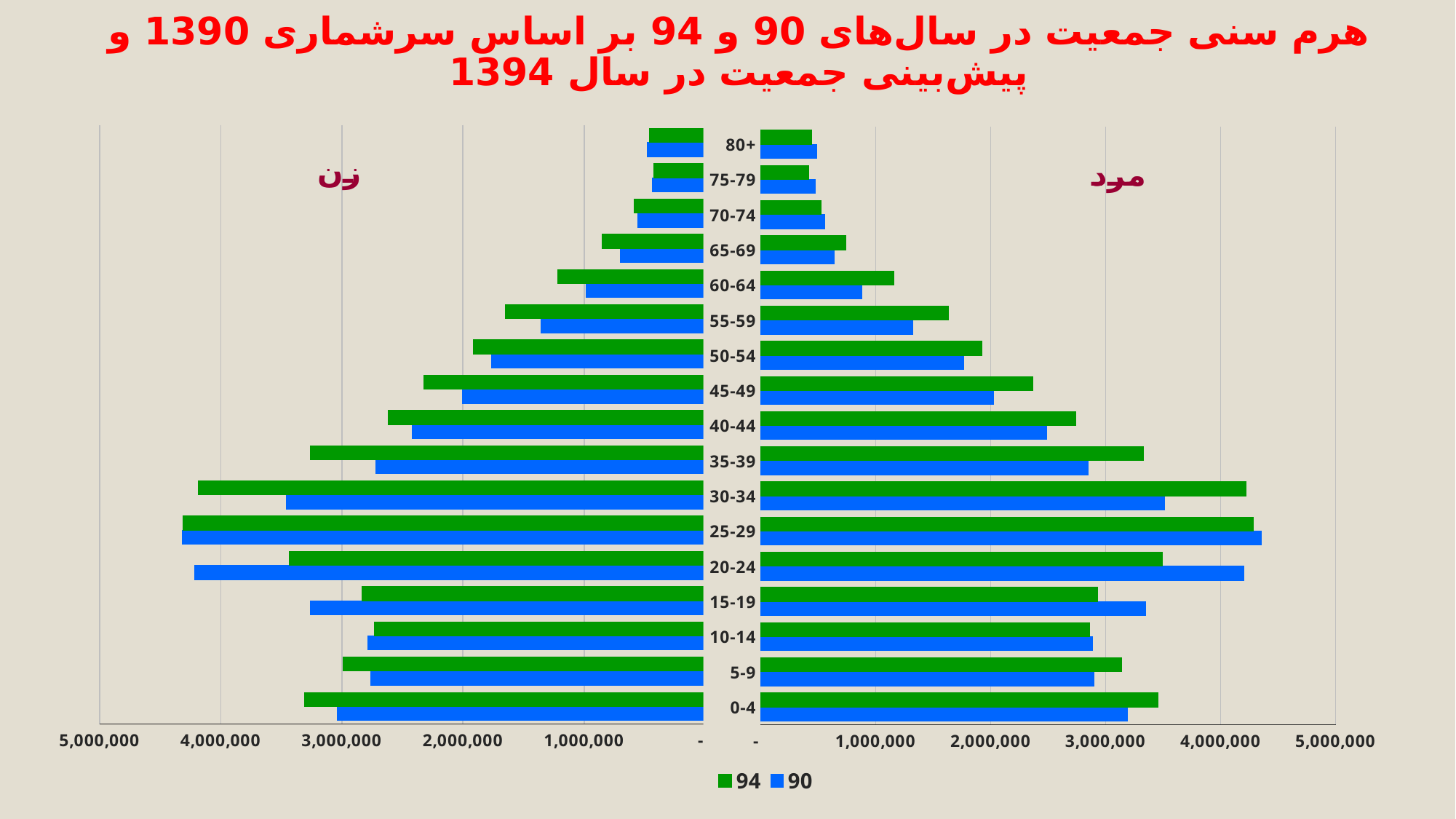
What are the two series named in the legend? 94 and 90 How many age groups are plotted on the chart? 17 On the women's (زن) side, for the 30-34 age group, which series has the larger value, 90 or 94? 94 Which colour represents the 94 series in the chart? green On the women's (زن) side, is the 90 value for the 20-24 age group greater or less than 4,000,000? greater On the men's (مرد) side, is the 94 value for the 45-49 age group greater or less than 2,000,000? greater How many series does the legend list? 2 On the men's (مرد) side, is the 90 value for the 60-64 age group greater or less than 1,000,000? less On the men's (مرد) side, for the 20-24 age group, which series has the larger value, 90 or 94? 90 What kind of chart is shown on the slide? bar chart